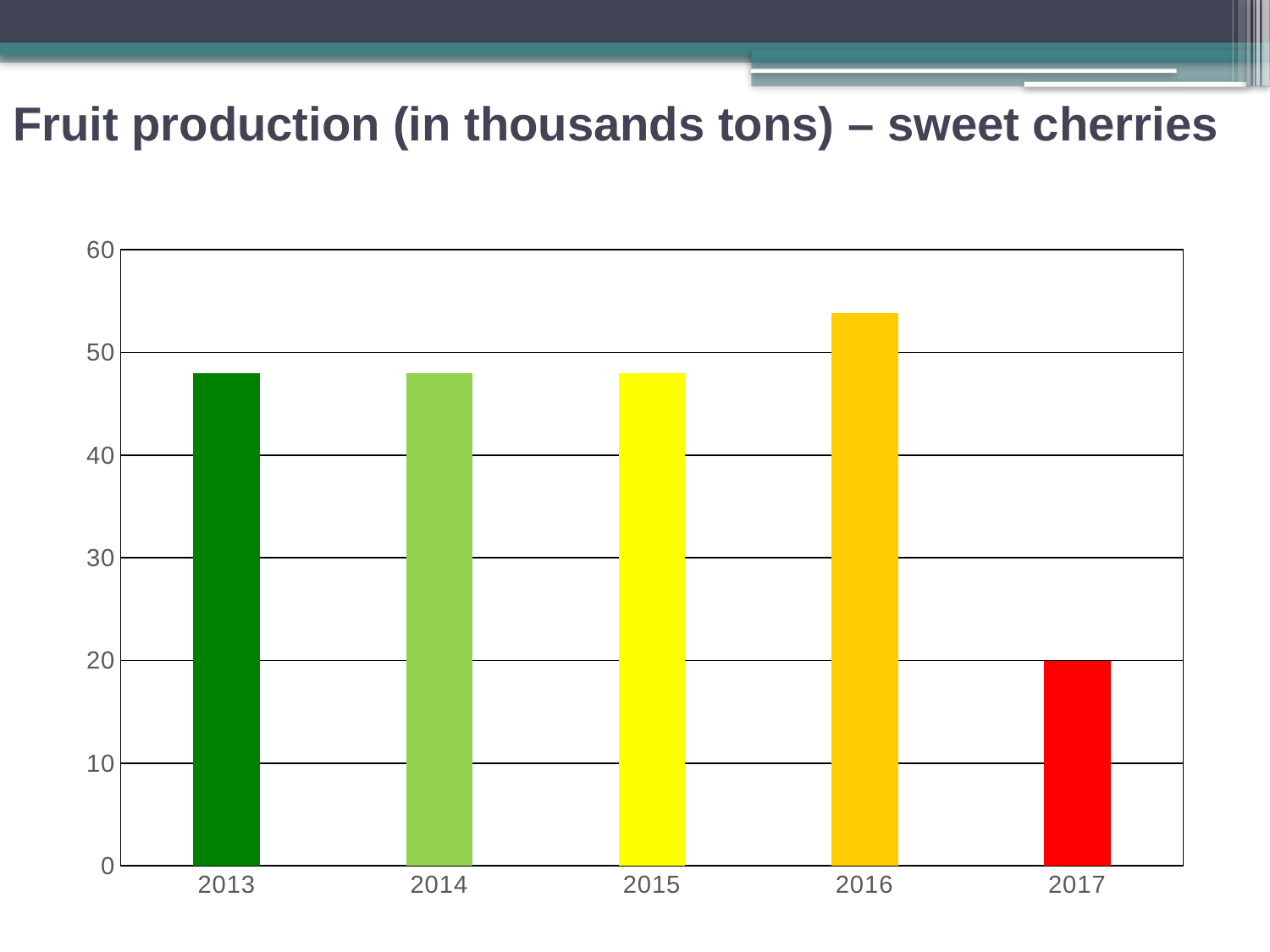
How many years are shown on the x axis of the chart? 5 What is the title of the chart on the slide? Fruit production (in thousands tons) – sweet cherries Is the value for 2017 greater or less than 30? less Is the value for 2015 greater or less than 50? less Does the value rise or fall from 2016 to 2017? fall What is the sweet cherry production value for 2017? 20 Which year has the lowest sweet cherry production? 2017 Is the value for 2016 greater or less than 50? greater What kind of chart is shown on the slide? bar chart Which year has the larger value, 2016 or 2014? 2016 Which year has the highest sweet cherry production? 2016